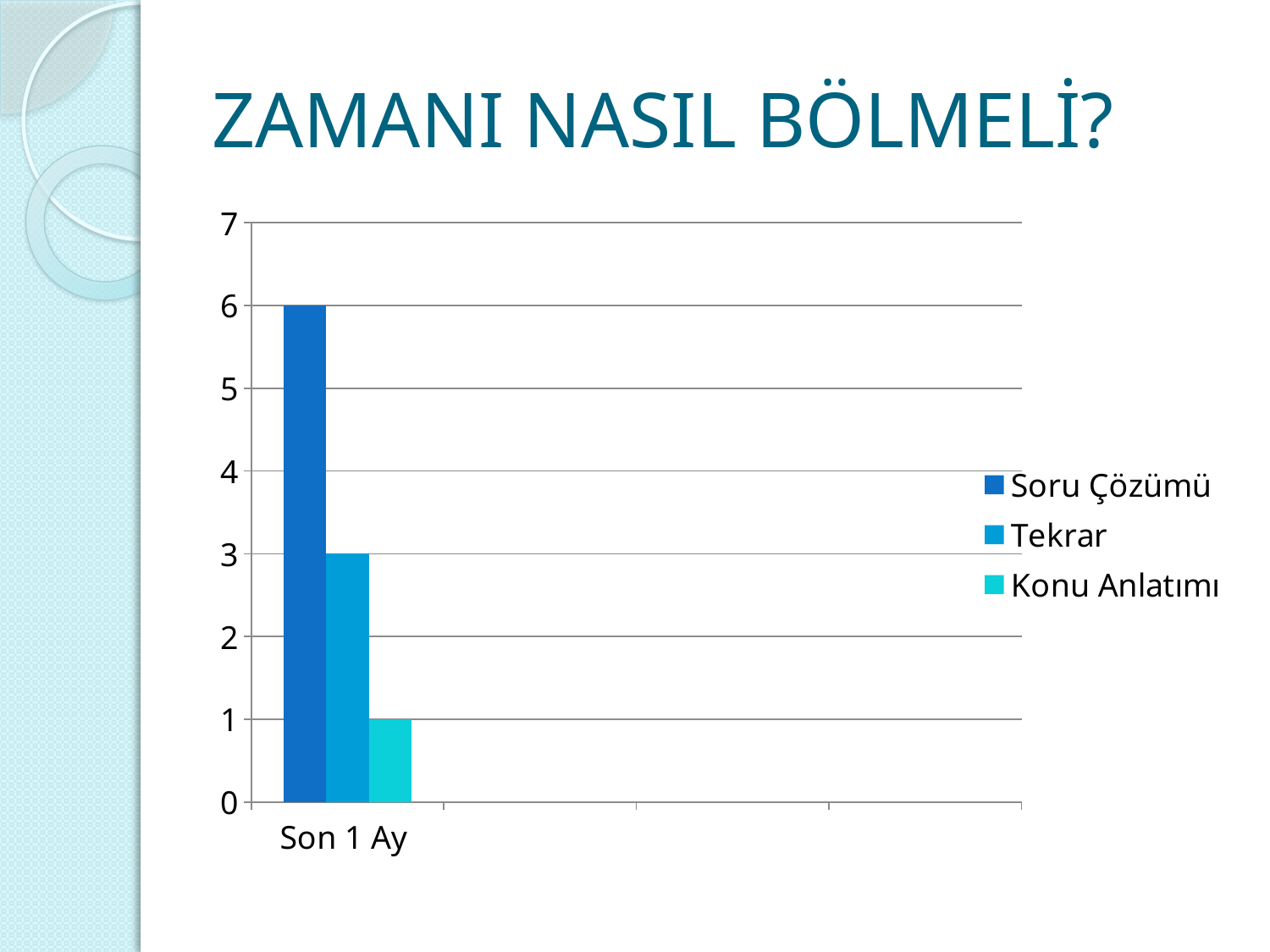
Is the value for Soru Çözümü greater or less than 5? greater How many categories are shown on the x axis? 1 What kind of chart is shown on the slide? bar chart What is the value for Soru Çözümü in Son 1 Ay? 6 What is the value for Tekrar in Son 1 Ay? 3 Which series has the highest value in Son 1 Ay? Soru Çözümü How many series does the legend list? 3 Which series has the lowest value in Son 1 Ay? Konu Anlatımı What is the difference between the values for Soru Çözümü and Tekrar? 3 Which is larger, the value for Tekrar or the value for Konu Anlatımı? Tekrar What is the label of the only category on the x axis? Son 1 Ay What is the value for Konu Anlatımı in Son 1 Ay? 1